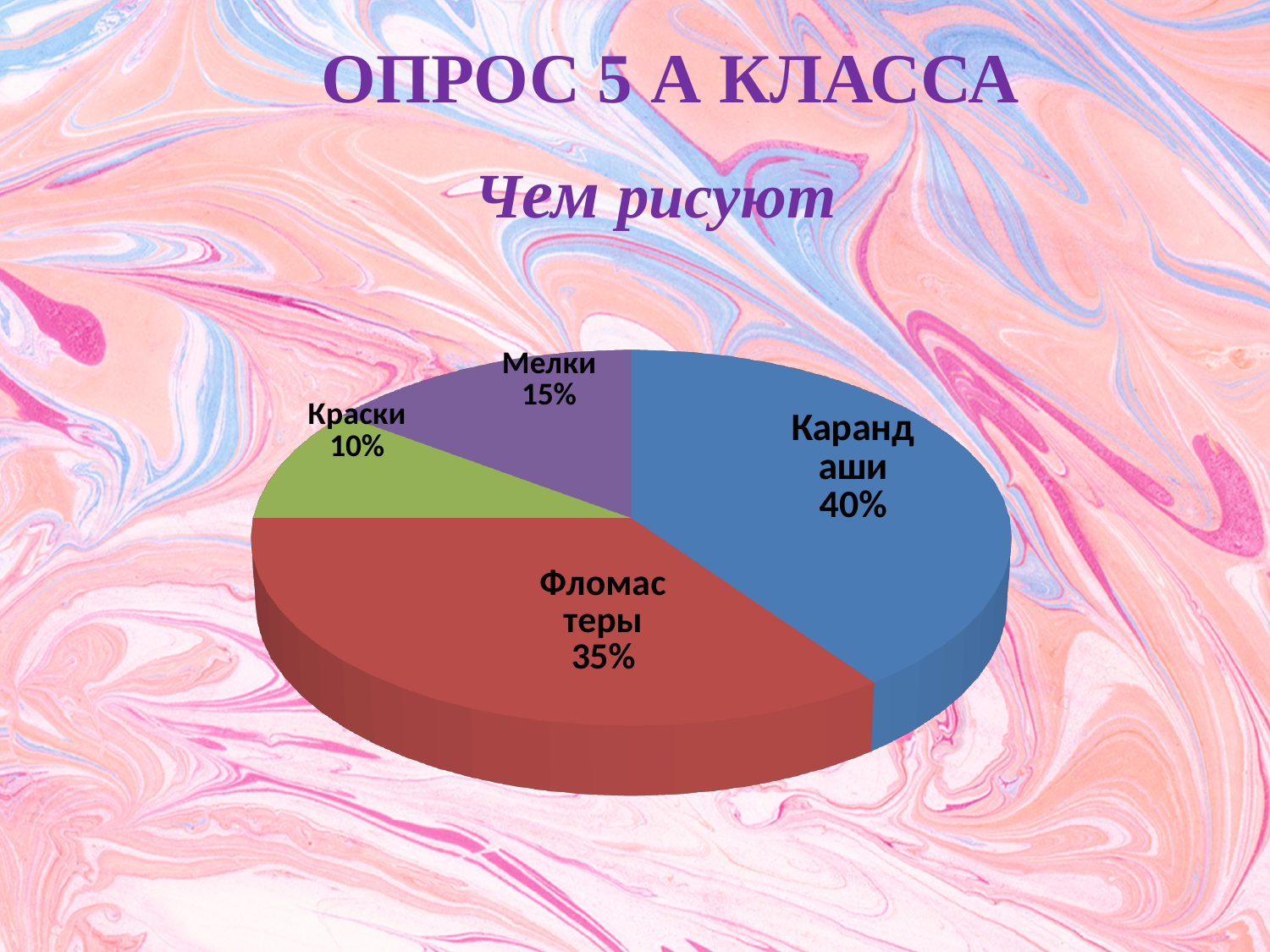
Which category has the largest slice of the pie? Карандаши What share of the pie does Краски have? 10% How many categories are shown in the pie chart? 4 What is the title of the chart? Чем рисуют Which category has the smallest slice of the pie? Краски What share of the pie does Карандаши have? 40% What kind of chart is shown on the slide? pie chart What share of the pie does Мелки have? 15% What is the difference in percentage points between Карандаши and Фломастеры? 5% Which is larger, the share for Мелки or the share for Краски? Мелки What is the difference in percentage points between Мелки and Краски? 5%